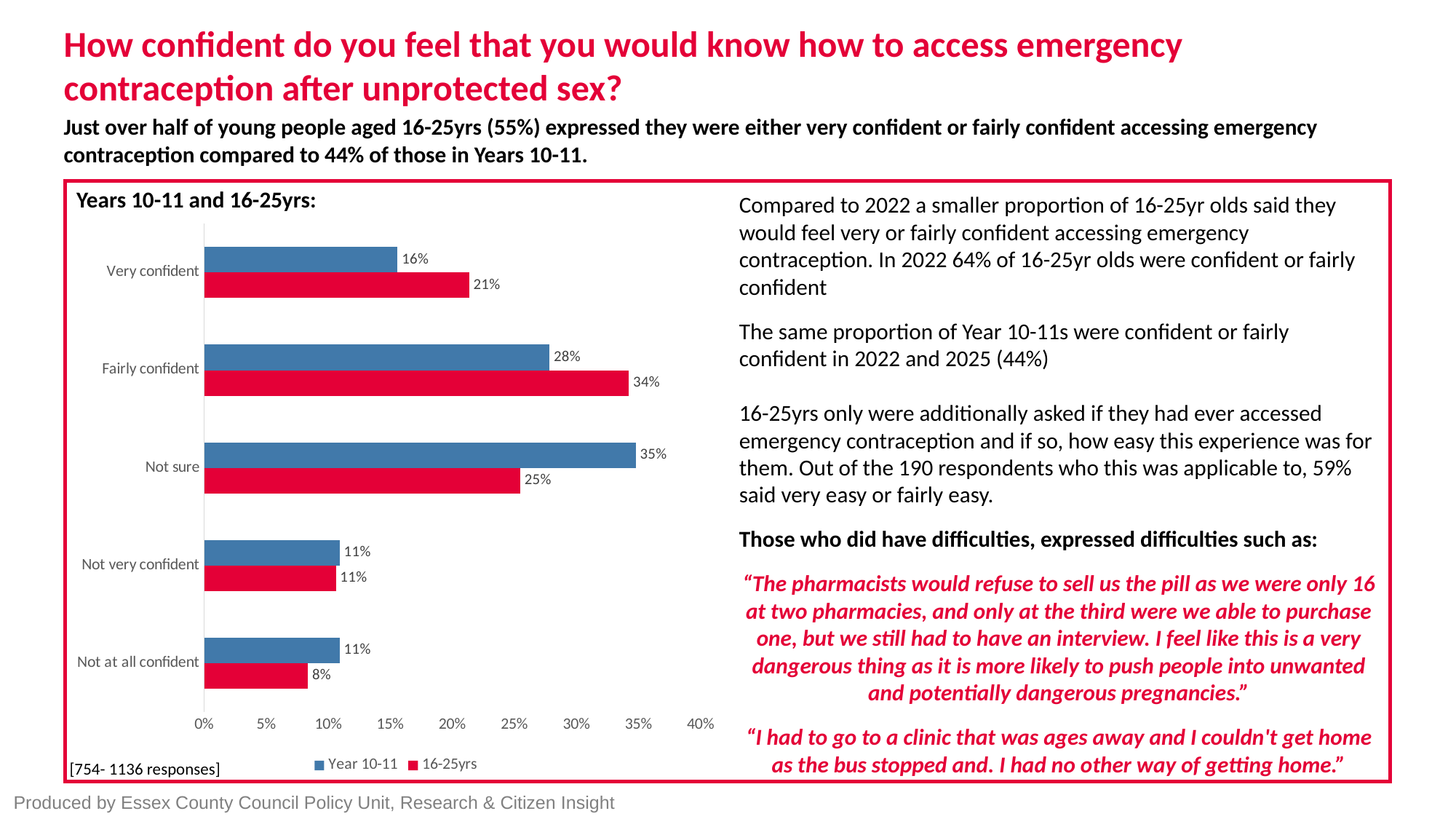
What percentage of Year 10-11 respondents said they were 'Very confident'? 16% What percentage of 16-25yrs respondents said they were 'Fairly confident'? 34% Which category has the lowest value for the 16-25yrs series? Not at all confident Is the Year 10-11 value for 'Not sure' greater or less than 30%? greater For 'Not sure', which series has the larger value, Year 10-11 or 16-25yrs? Year 10-11 What type of chart is shown on the slide? Bar chart Which category has the highest value for the Year 10-11 series? Not sure How many response categories are shown on the chart? 5 What percentage of 16-25yrs respondents said they were 'Not at all confident'? 8% How many series does the legend list? 2 Which colour represents the 16-25yrs series in the chart? Red What is the difference between the 16-25yrs and Year 10-11 values for 'Fairly confident'? 6%